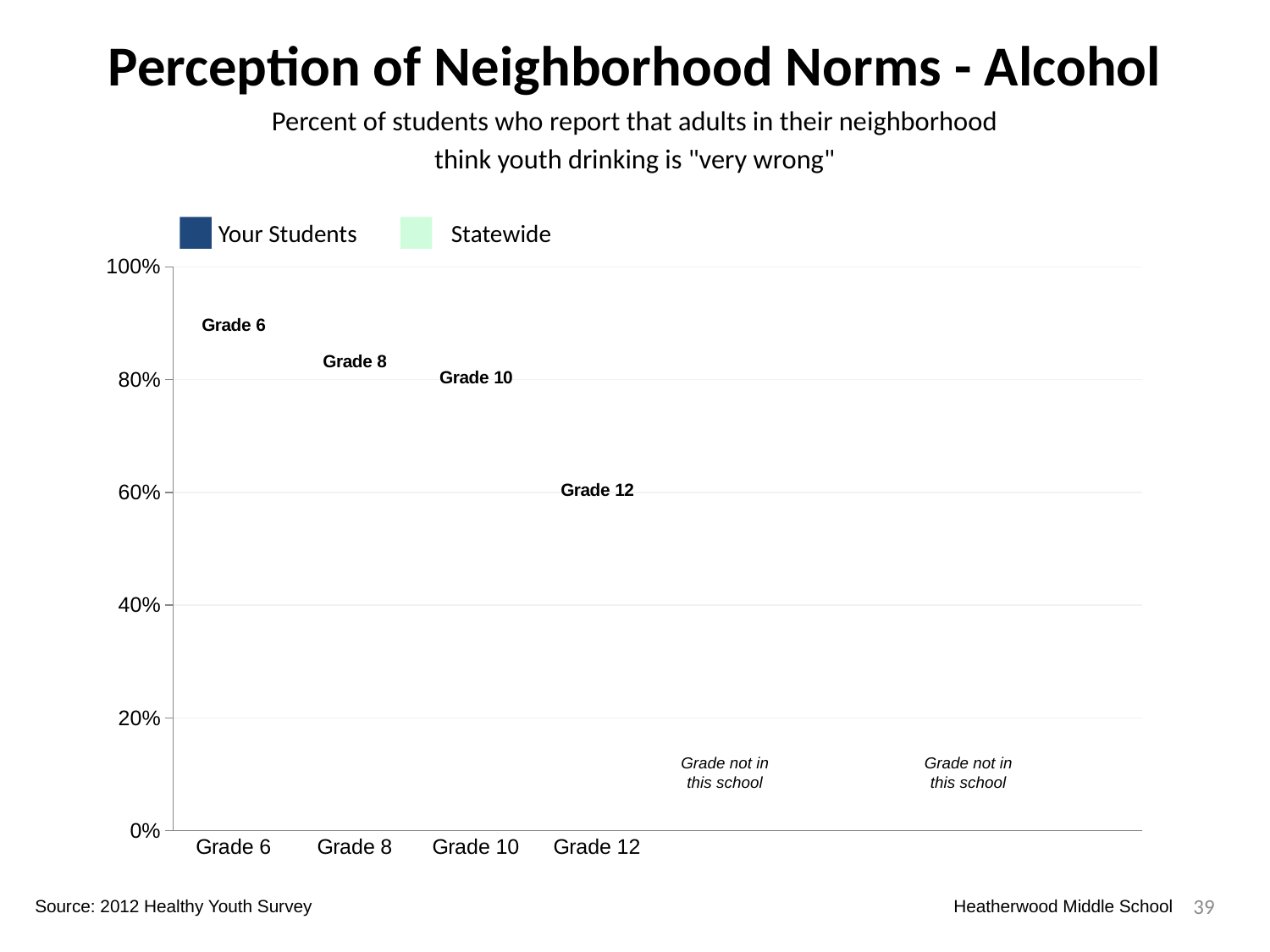
Is the Grade 12 label positioned above or below the 80% gridline? below How many grade categories are labeled on the x axis? 4 What is the title of the chart? Perception of Neighborhood Norms - Alcohol How many positions on the chart are marked "Grade not in this school"? 2 How many series does the legend list? 2 What is the highest value shown on the y axis? 100% Which grade's label is positioned lowest on the chart? Grade 12 What are the two series named in the legend? Your Students and Statewide Which grade's label is positioned highest on the chart? Grade 6 Is the Grade 6 label positioned above or below the 80% gridline? above Do the grade labels move higher or lower on the chart going from Grade 6 to Grade 12? lower